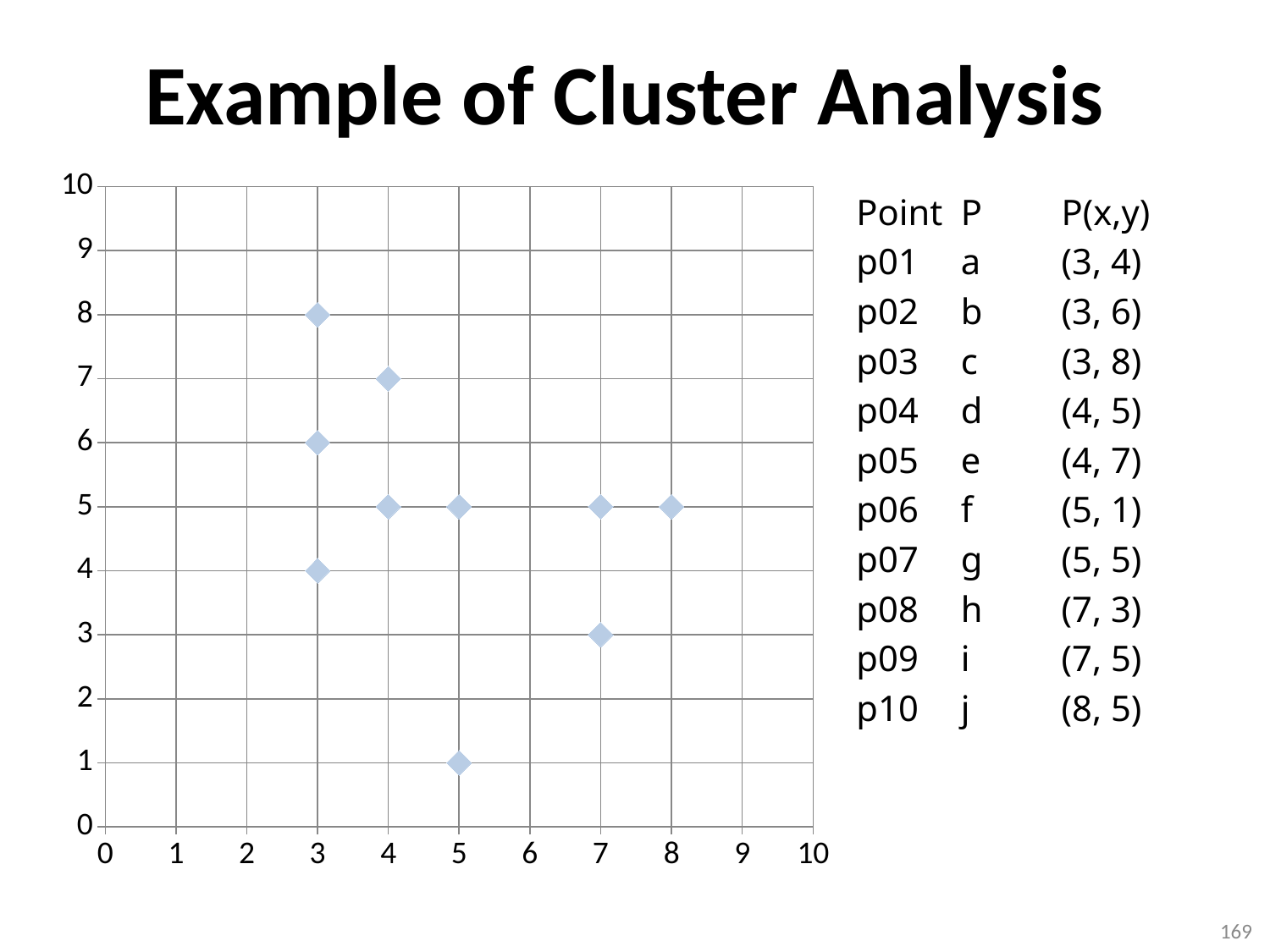
How many points are plotted at x = 3? 3 What is the largest x value among the plotted points? 8 How many points are plotted at y = 5? 4 What is the difference between the highest and lowest y values of the plotted points? 7 What is the y value of the point plotted at x = 8? 5 What is the title of the slide containing the chart? Example of Cluster Analysis Is the y value of the point at x = 5 with the lowest y greater or less than 2? less What is the x value of the point plotted at y = 1? 5 What is the lowest y value among the plotted points? 1 What is the highest y value among the plotted points? 8 How many data points are plotted on the chart? 10 What kind of chart is shown on the slide? scatter chart